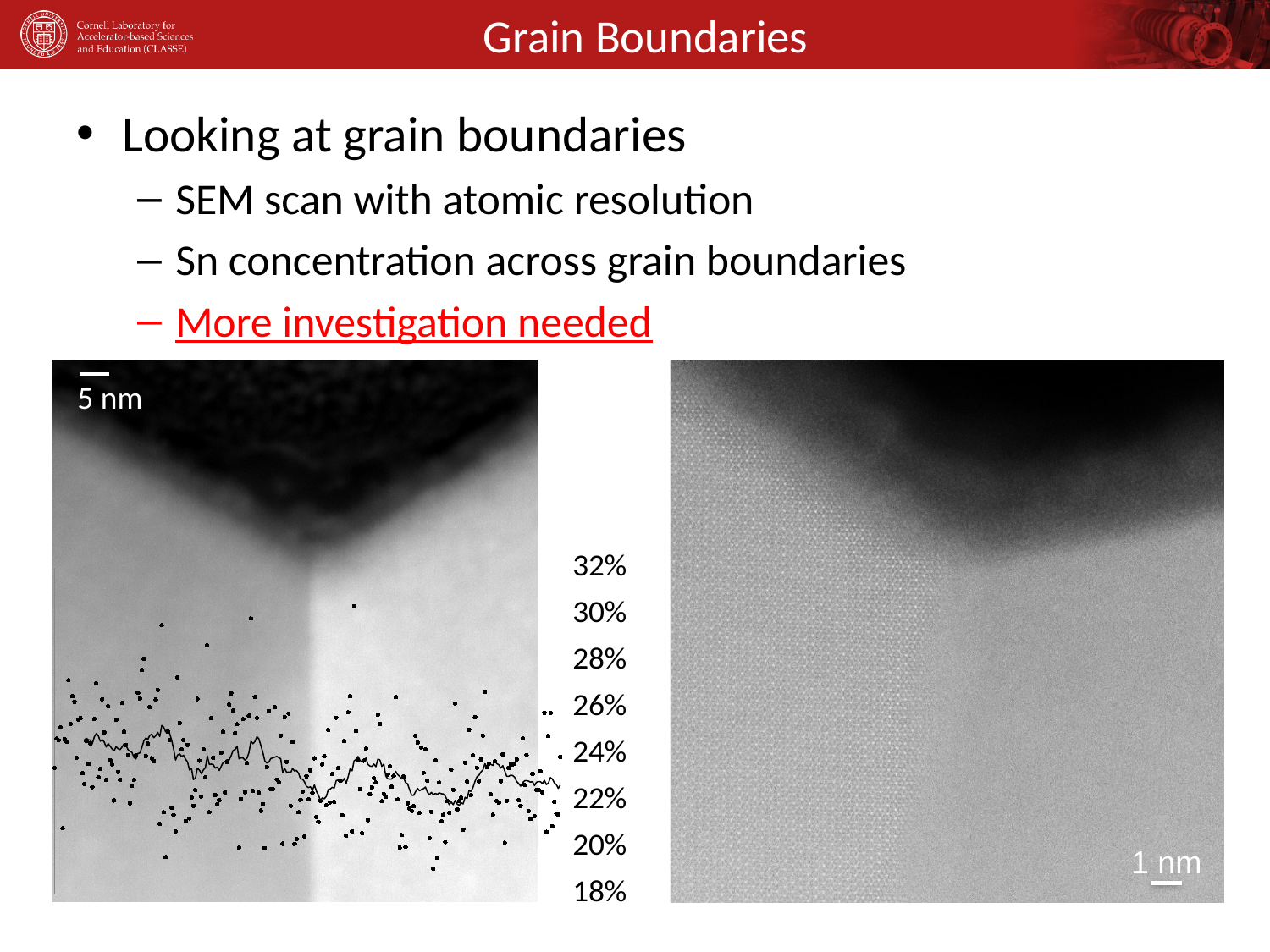
What length does the scale bar on the right image represent? 1 nm How many tick labels are shown on the vertical axis of the chart on the left image? 8 What is the highest value labelled on the vertical axis of the chart on the left image? 32% What quantity does the chart on the left image plot, according to the slide text? Sn concentration across grain boundaries Does the smoothed line in the chart on the left image stay above or below 20% across the whole plot? above What kind of chart is overlaid on the left image? scatter chart Does the smoothed line in the chart on the left image stay above or below 30% across the whole plot? below